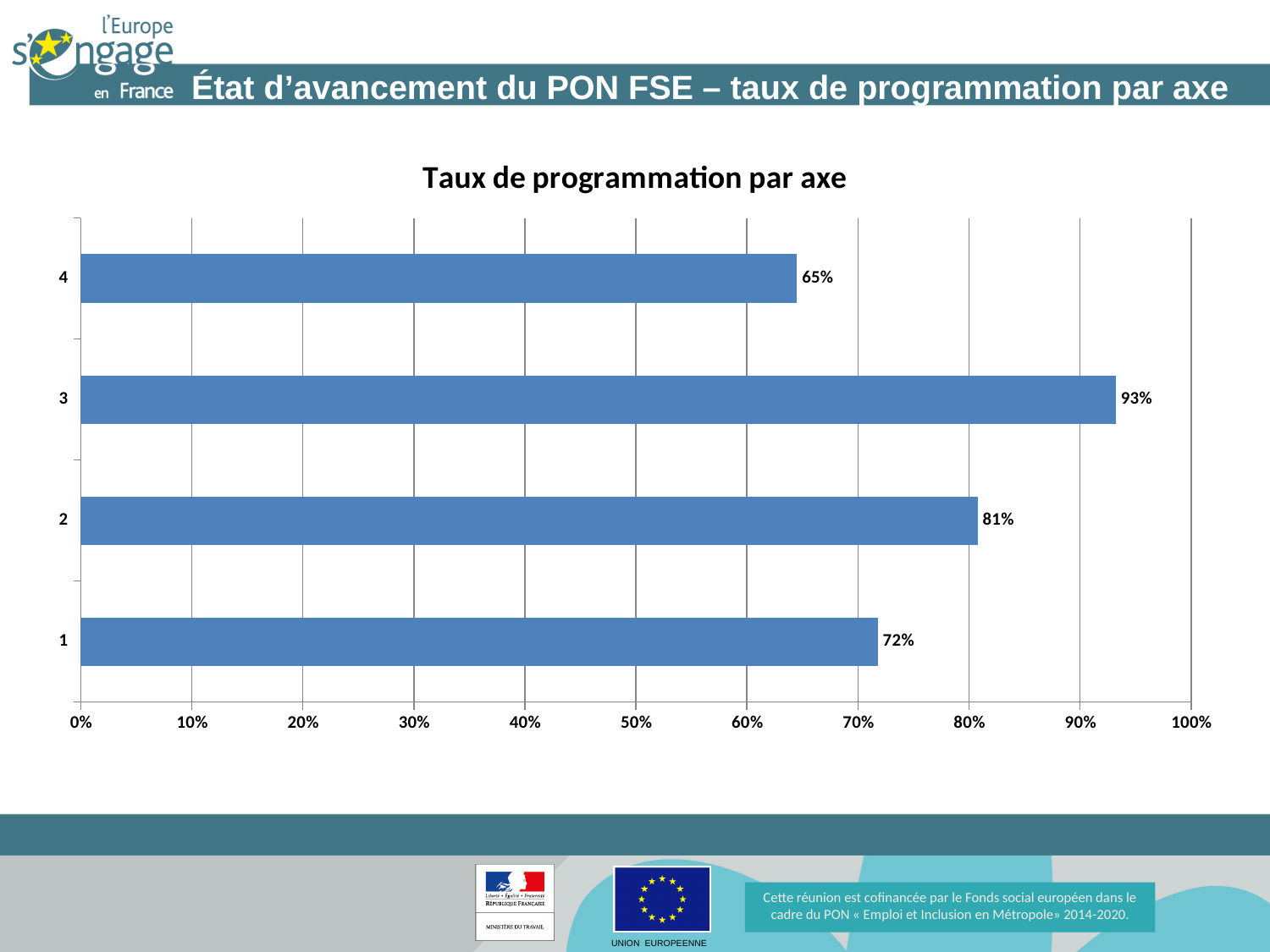
What is the programming rate for axe 4? 65% What type of chart is shown on the slide? bar chart What is the programming rate for axe 1? 72% How many axes are shown in the chart? 4 Which has a higher programming rate, axe 1 or axe 2? 2 Which axe has the lowest programming rate? 4 Which axe has the highest programming rate? 3 What is the difference between the programming rates of axe 2 and axe 1? 9% What is the programming rate for axe 3? 93% Is the value for axe 2 greater or less than 80%? greater What is the difference between the programming rates of axe 3 and axe 4? 28% What is the title of the chart? Taux de programmation par axe